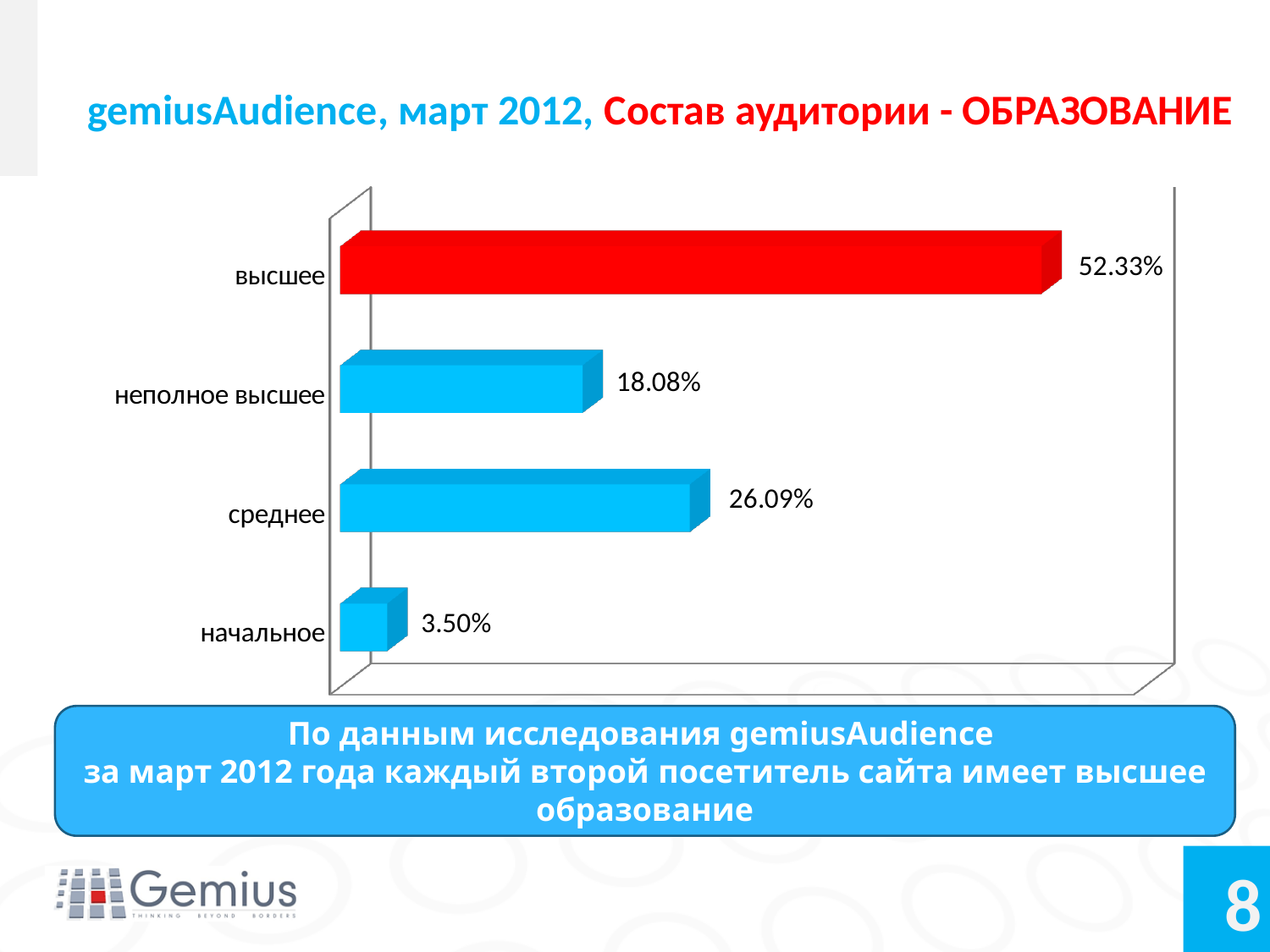
What is the value for высшее? 52.33% What is the difference between the values for среднее and неполное высшее? 8.01% What is the value for начальное? 3.50% Which category has the lowest value? начальное What is the difference between the values for высшее and среднее? 26.24% What is the value for среднее? 26.09% How many categories are shown in the chart? 4 What kind of chart is shown on the slide? bar chart Which is larger, the value for среднее or the value for неполное высшее? среднее What is the value for неполное высшее? 18.08% Which category has the highest value? высшее Which bar is coloured red rather than blue? высшее